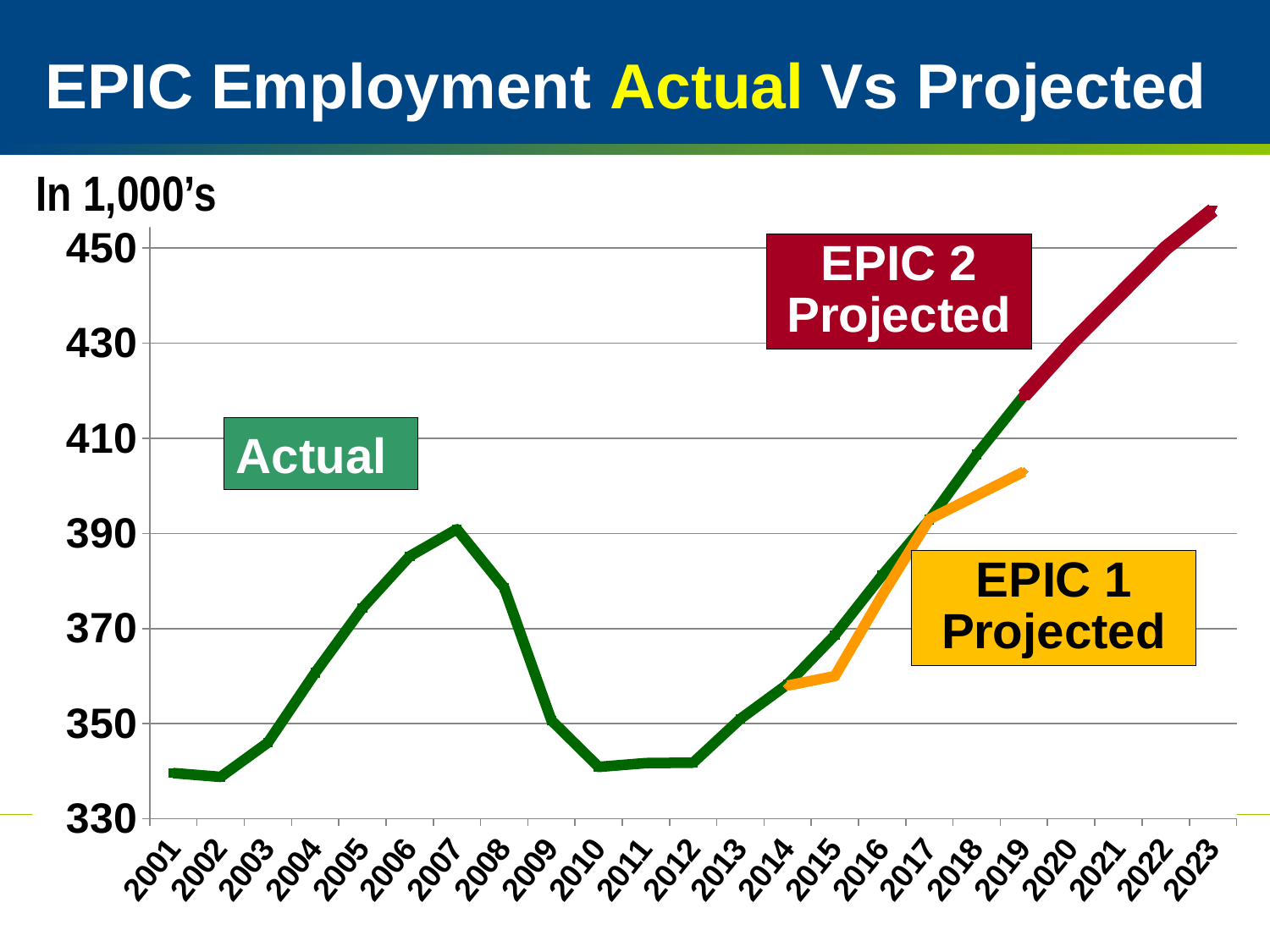
Is the Actual value for 2001 greater or less than 350? less Is the EPIC 2 Projected value for 2023 greater or less than 450? greater Does the EPIC 2 Projected line rise or fall from 2019 to 2023? rise Is the Actual value for 2006 greater or less than 370? greater How many series are labelled on the chart? 3 Which is larger, the Actual value for 2007 or the Actual value for 2019? 2019 Does the Actual line rise or fall from 2007 to 2010? fall What kind of chart is shown on the slide? line chart In what units are the values on the chart expressed? In 1,000's How many years are labelled on the x axis? 23